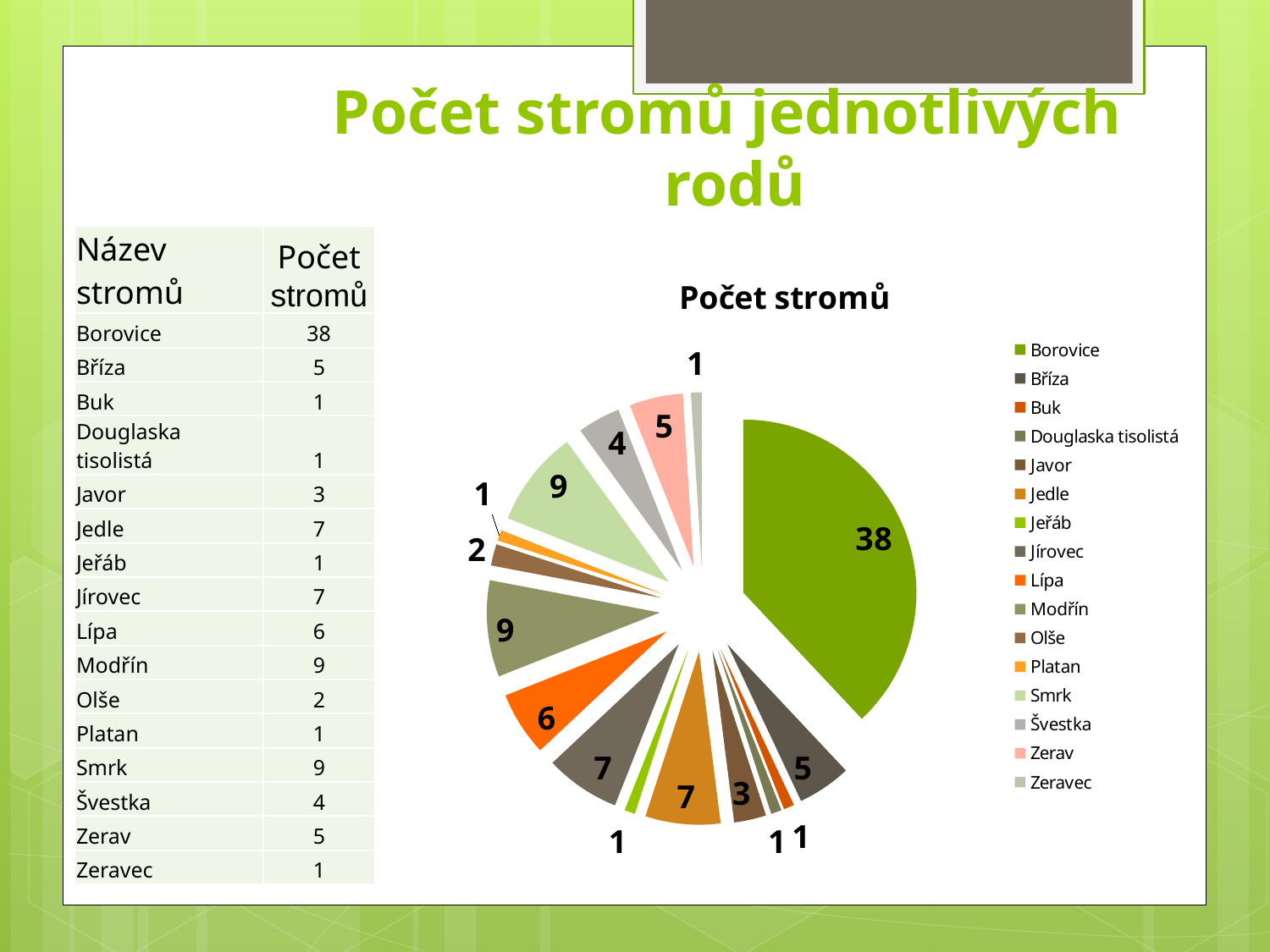
Which category has the largest slice in the pie chart? Borovice What is the value for Javor in the pie chart? 3 What share of the pie does Borovice represent? 38% What is the difference between the values for Jedle and Olše? 5 What kind of chart is shown on the slide? pie chart Which is larger, the value for Lípa or the value for Švestka? Lípa What is the value for Borovice in the pie chart? 38 What is the difference between the values for Borovice and Modřín? 29 How many categories does the pie chart show? 16 What is the title of the chart? Počet stromů What is the value for Lípa in the pie chart? 6 How many entries does the legend of the pie chart list? 16